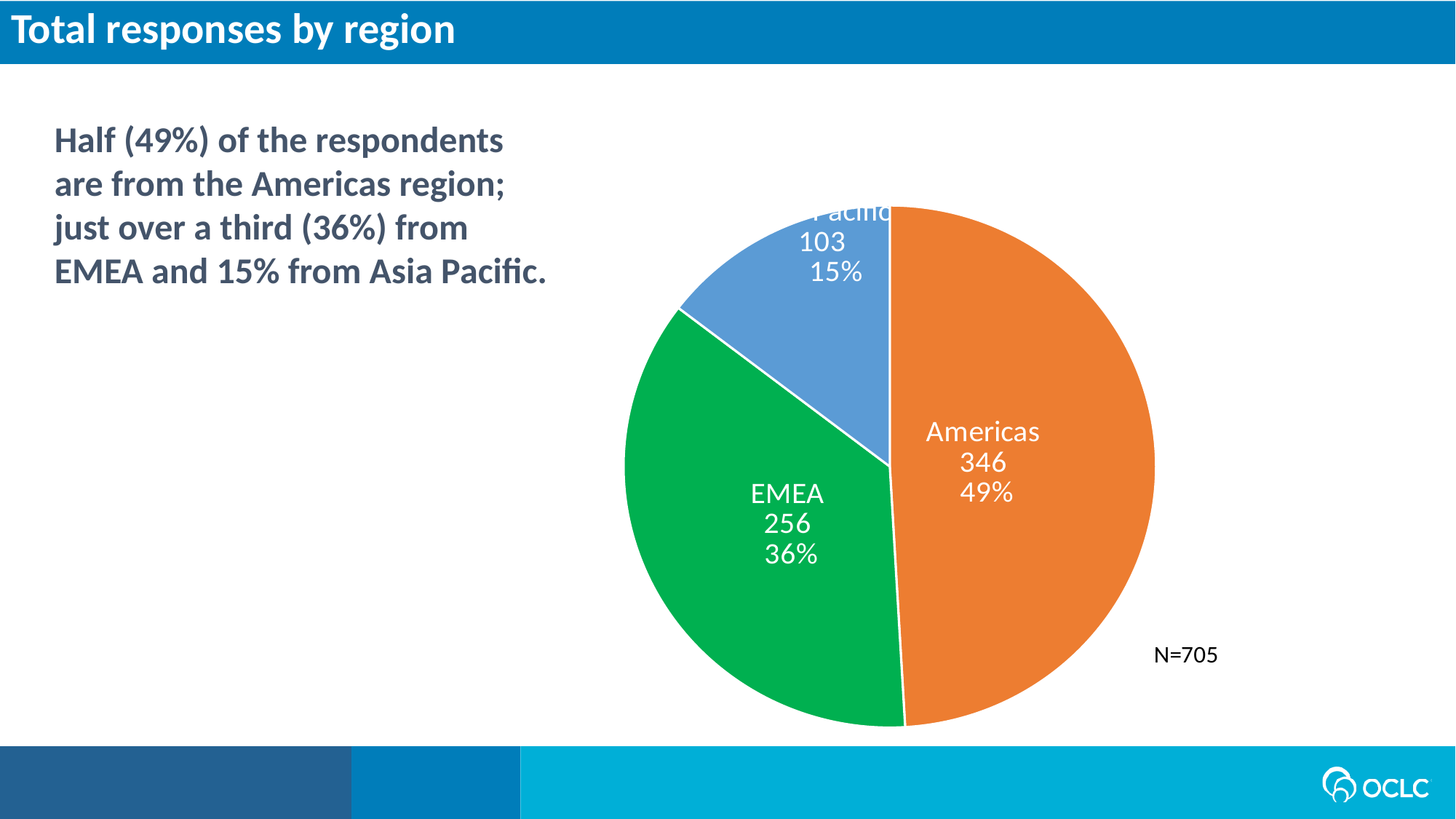
What share of the pie does the Asia Pacific slice represent? 15% Which region has the highest number of responses? Americas Which region has the lowest number of responses? Asia Pacific What share of the pie does the Americas slice represent? 49% What kind of chart is shown on the slide? pie chart Which region has more responses, EMEA or Asia Pacific? EMEA What is the difference in responses between the Americas and EMEA? 90 What share of the pie does the EMEA slice represent? 36% How many responses are from the Americas region? 346 How many responses are from Asia Pacific? 103 How many regions are shown in the pie chart? 3 How many responses are from EMEA? 256